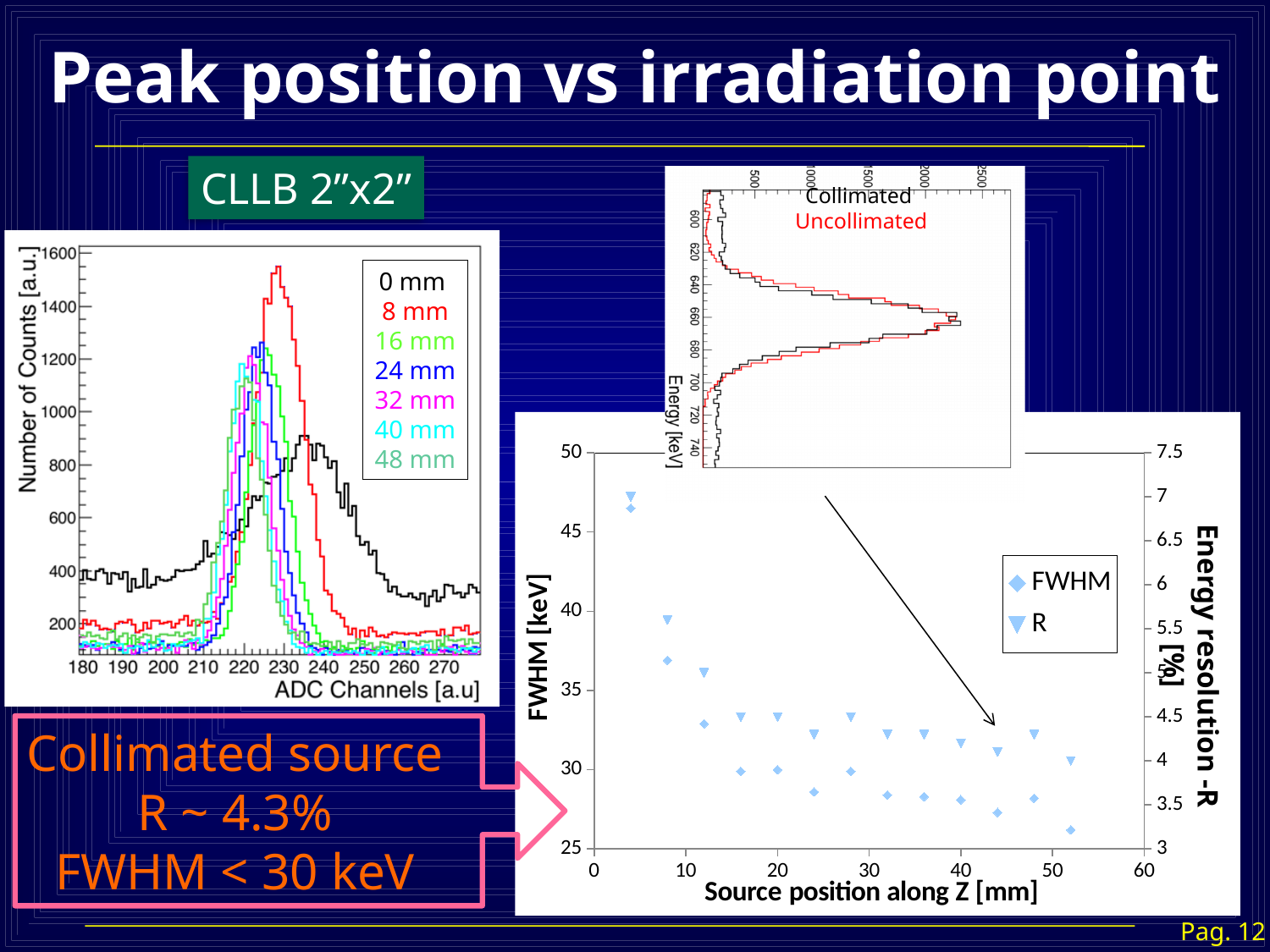
In the bottom-right chart, is the FWHM value at source position 4 mm greater or less than 45? greater In the bottom-right chart, at which source position is FWHM highest? 4 mm In the bottom-right chart, how many FWHM data points are plotted? 13 In the left chart (Number of Counts vs ADC Channels), how many irradiation positions does the legend list? 7 In the bottom-right chart, is the FWHM value at source position 52 mm greater or less than 30? less In the left chart (Number of Counts vs ADC Channels), which irradiation position has the highest peak? 8 mm In the bottom-right chart, is the R value at source position 4 mm greater or less than 6.5 on the right axis? greater In the bottom-right chart, what is the label of the x axis? Source position along Z [mm] In the bottom-right chart, at which source position is FWHM lowest? 52 mm In the bottom-right chart, how many series does the legend list? 2 In the bottom-right chart, does FWHM generally rise or fall as the source position along Z increases? fall In the bottom-right chart, what are the two series named in the legend? FWHM and R